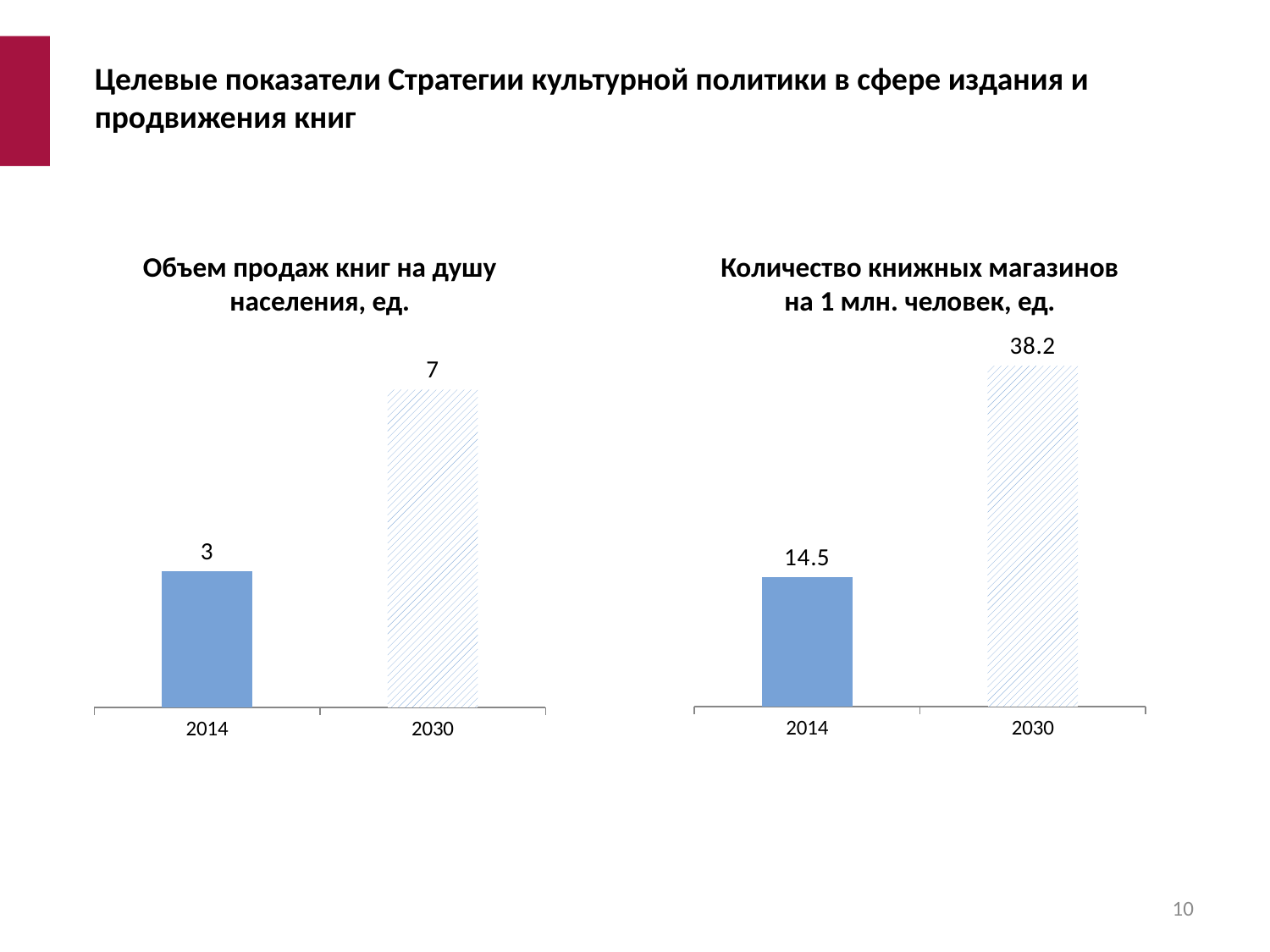
In the left chart (Объем продаж книг на душу населения, ед.), what is the difference between the 2030 and 2014 values? 4 In the left chart (Объем продаж книг на душу населения, ед.), what is the value for 2014? 3 In the right chart (Количество книжных магазинов на 1 млн. человек, ед.), what is the difference between the 2030 and 2014 values? 23.7 In the left chart (Объем продаж книг на душу населения, ед.), which year has the higher value? 2030 In the right chart (Количество книжных магазинов на 1 млн. человек, ед.), which year has the lower value? 2014 In the left chart (Объем продаж книг на душу населения, ед.), do the values rise or fall from 2014 to 2030? rise In the right chart (Количество книжных магазинов на 1 млн. человек, ед.), is the value for 2014 larger or smaller than the value for 2030? smaller How many categories are shown on the x axis of the left chart (Объем продаж книг на душу населения, ед.)? 2 In the left chart (Объем продаж книг на душу населения, ед.), what is the value for 2030? 7 In the right chart (Количество книжных магазинов на 1 млн. человек, ед.), what is the value for 2014? 14.5 In the right chart (Количество книжных магазинов на 1 млн. человек, ед.), what is the value for 2030? 38.2 What kind of chart is the right chart (Количество книжных магазинов на 1 млн. человек, ед.)? bar chart